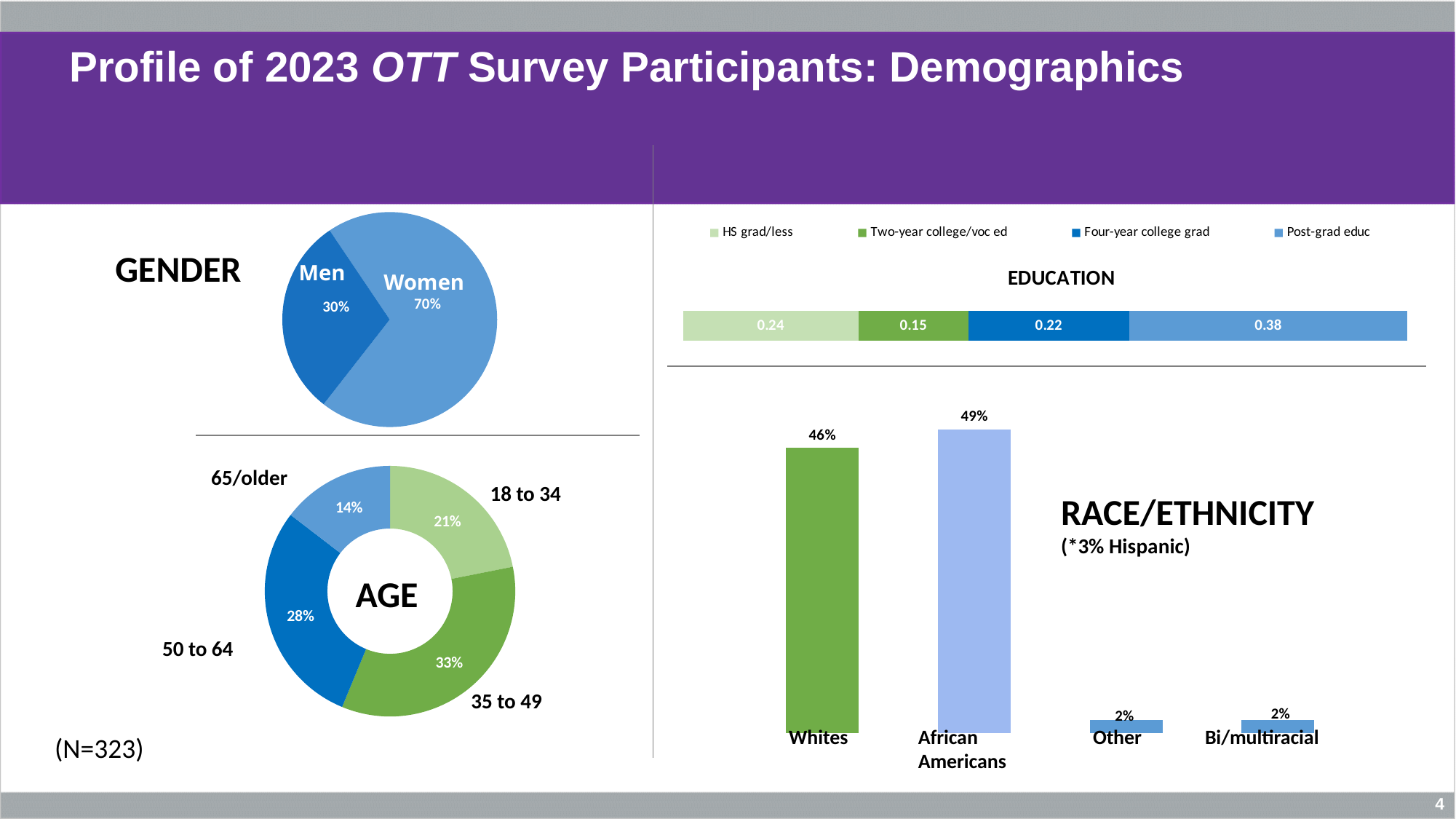
In the EDUCATION chart, what is the value for Post-grad educ? 0.38 In the RACE/ETHNICITY chart, which is larger, Whites or African Americans? African Americans In the GENDER pie chart, what percentage of participants are men? 30% In the AGE donut chart, what is the value for the 35 to 49 group? 33% In the AGE donut chart, which age group has the largest share? 35 to 49 How many series does the legend of the EDUCATION chart list? 4 In the GENDER pie chart, what percentage of participants are women? 70% In the AGE donut chart, what is the difference between the 50 to 64 and 18 to 34 shares? 7% In the EDUCATION chart, which education category has the lowest value? Two-year college/voc ed In the RACE/ETHNICITY chart, what is the value for African Americans? 49% In the AGE donut chart, how many age groups are shown? 4 In the AGE donut chart, which age group has the smallest share? 65/older